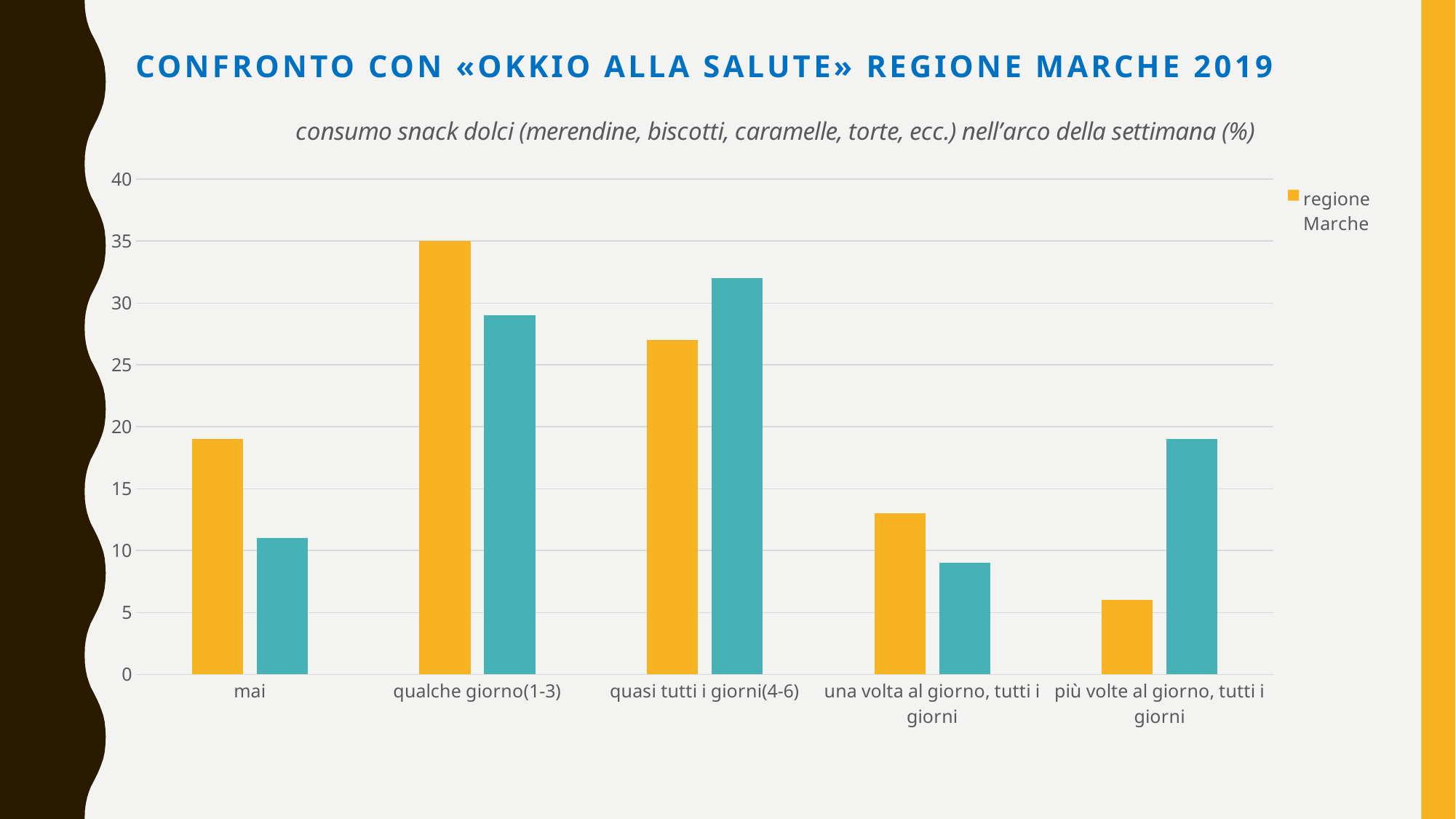
Is the value for regione Marche in the category 'più volte al giorno, tutti i giorni' greater or less than 10? less How many categories are shown on the x axis of the chart? 5 What is the value for regione Marche in the category 'qualche giorno(1-3)'? 35 Is the value for regione Marche in the category 'mai' greater or less than 15? greater Which category has the highest value for regione Marche? qualche giorno(1-3) Which category has the lowest value for regione Marche? più volte al giorno, tutti i giorni What kind of chart is shown on the slide? bar chart In the category 'più volte al giorno, tutti i giorni', which bar is taller: the yellow regione Marche bar or the teal bar? the teal bar How many series does the chart's legend list? 1 In the category 'mai', which bar is taller: the yellow regione Marche bar or the teal bar? the yellow regione Marche bar Is the value for regione Marche in the category 'una volta al giorno, tutti i giorni' greater or less than 15? less Which series is named in the chart's legend? regione Marche